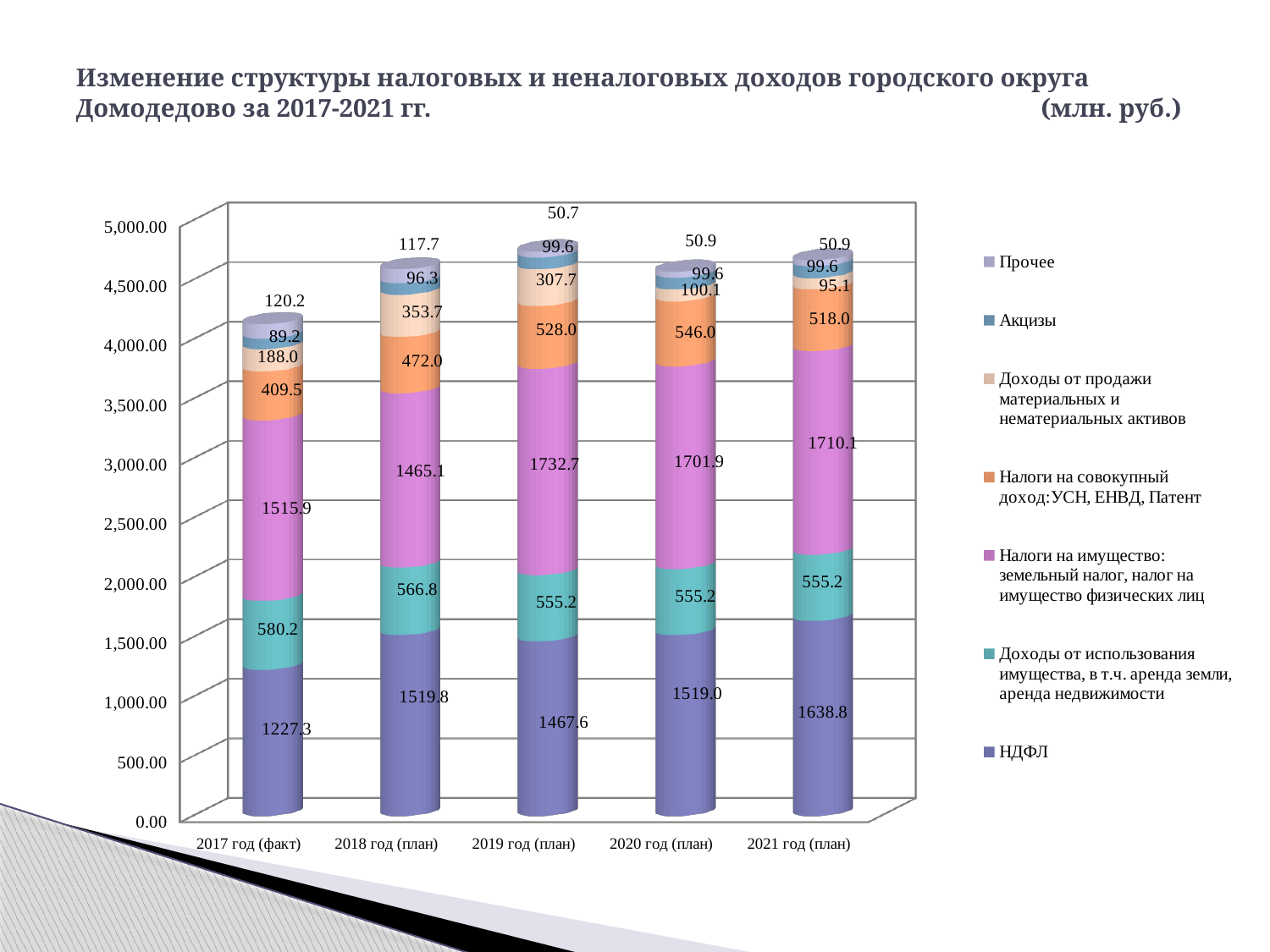
Which year has the larger value for Налоги на совокупный доход: УСН, ЕНВД, Патент, 2019 год (план) or 2020 год (план)? 2020 год (план) What is the difference between the НДФЛ value for 2021 год (план) and for 2017 год (факт)? 411.5 What is the value of НДФЛ for 2021 год (план)? 1638.8 How many years (categories) are shown on the x axis? 5 What kind of chart is shown on the slide? Stacked bar chart In which year is the НДФЛ value the highest? 2021 год (план) What is the value of Налоги на имущество: земельный налог, налог на имущество физических лиц for 2019 год (план)? 1732.7 Do the values for Доходы от продажи материальных и нематериальных активов rise or fall from 2018 год (план) to 2021 год (план)? Fall How many series does the legend list? 7 In which year is the Налоги на имущество value the lowest? 2018 год (план) What is the total of the stacked bar for 2017 год (факт)? 4130.3 What is the value of Акцизы for 2017 год (факт)? 89.2